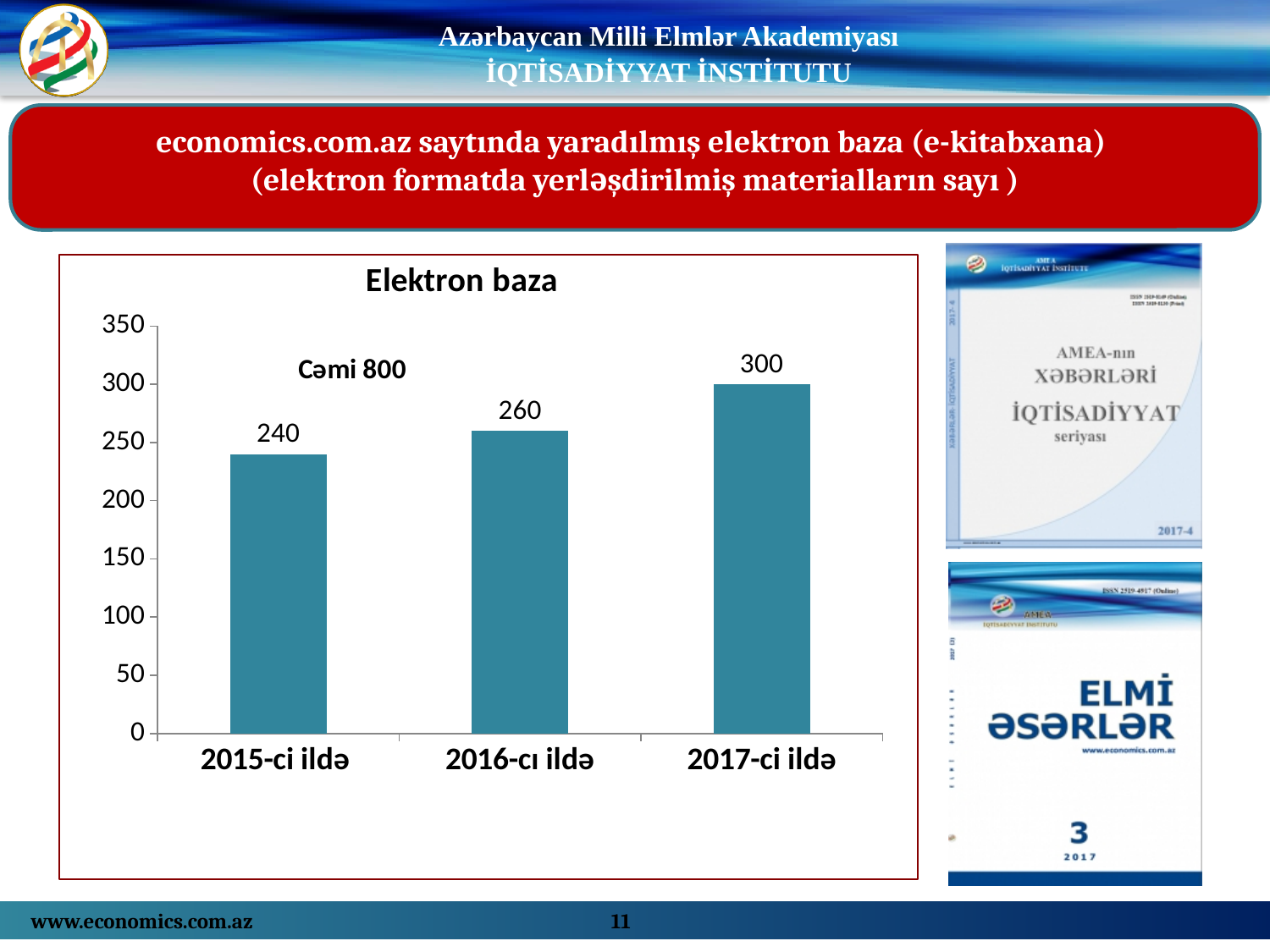
What is the value for 2016-cı ildə in the Elektron baza chart? 260 Is the value for 2015-ci ildə greater or less than 250? less What is the value for 2017-ci ildə in the Elektron baza chart? 300 Which year has the lowest value in the Elektron baza chart? 2015-ci ildə What is the difference between the values for 2017-ci ildə and 2015-ci ildə? 60 How many categories are shown on the x axis of the chart? 3 What is the value for 2015-ci ildə in the Elektron baza chart? 240 What is the difference between the values for 2016-cı ildə and 2015-ci ildə? 20 Which is larger, the value for 2016-cı ildə or the value for 2017-ci ildə? 2017-ci ildə What kind of chart is shown on the slide? bar chart Do the values rise or fall from 2015-ci ildə to 2017-ci ildə? rise Which year has the highest value in the Elektron baza chart? 2017-ci ildə